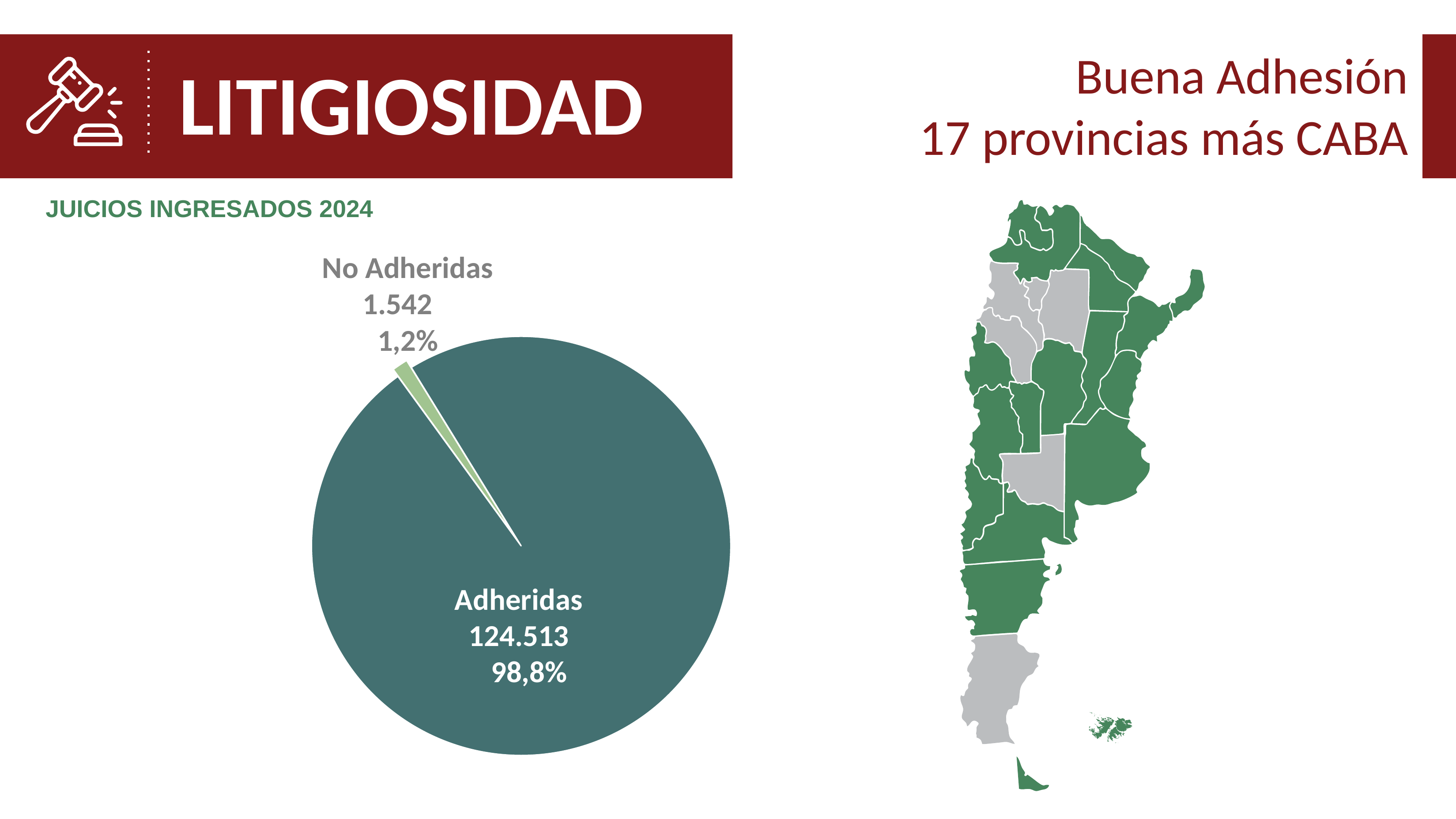
Which slice of the pie chart is the smallest? No Adheridas What is the difference between the Adheridas and No Adheridas values in the pie chart? 122.971 What is the value for Adheridas in the pie chart? 124.513 What is the value for No Adheridas in the pie chart? 1.542 What share of the pie does No Adheridas represent? 1,2% Which slice of the pie chart is the largest? Adheridas Which is larger in the pie chart, Adheridas or No Adheridas? Adheridas What share of the pie does Adheridas represent? 98,8% What kind of chart is shown under 'JUICIOS INGRESADOS 2024'? pie chart What colour is the No Adheridas slice in the pie chart? light green How many slices does the pie chart have? 2 What is the title of the pie chart? JUICIOS INGRESADOS 2024